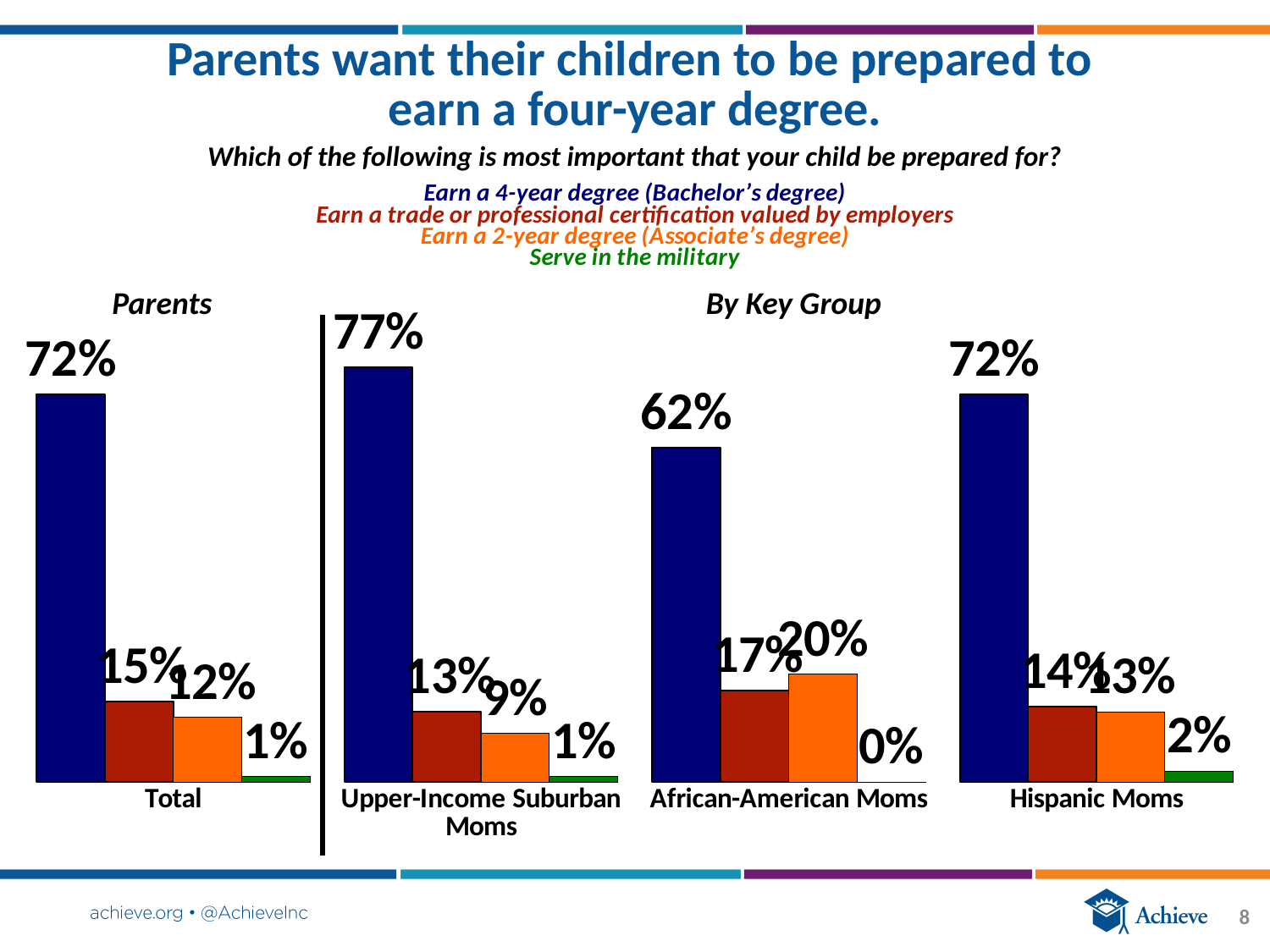
What colour are the bars for 'Earn a 4-year degree (Bachelor's degree)'? Dark blue What is the difference between the 4-year degree values for Upper-Income Suburban Moms and African-American Moms? 15% What percentage of African-American Moms say earning a 2-year degree is most important? 20% Which group has the lowest value for earning a 4-year degree? African-American Moms What percentage of Upper-Income Suburban Moms say earning a 4-year degree is most important? 77% Among African-American Moms, which is larger: the value for a trade certification or the value for a 2-year degree? 2-year degree What kind of chart is shown on the slide? Bar chart What is the value for 'Serve in the military' among Hispanic Moms? 2% What is the value for 'Earn a trade or professional certification valued by employers' in the Total group? 15% How many response options (series) does the legend list? 4 Which group has the highest value for earning a 4-year degree? Upper-Income Suburban Moms How many groups (categories) are shown along the x axis? 4